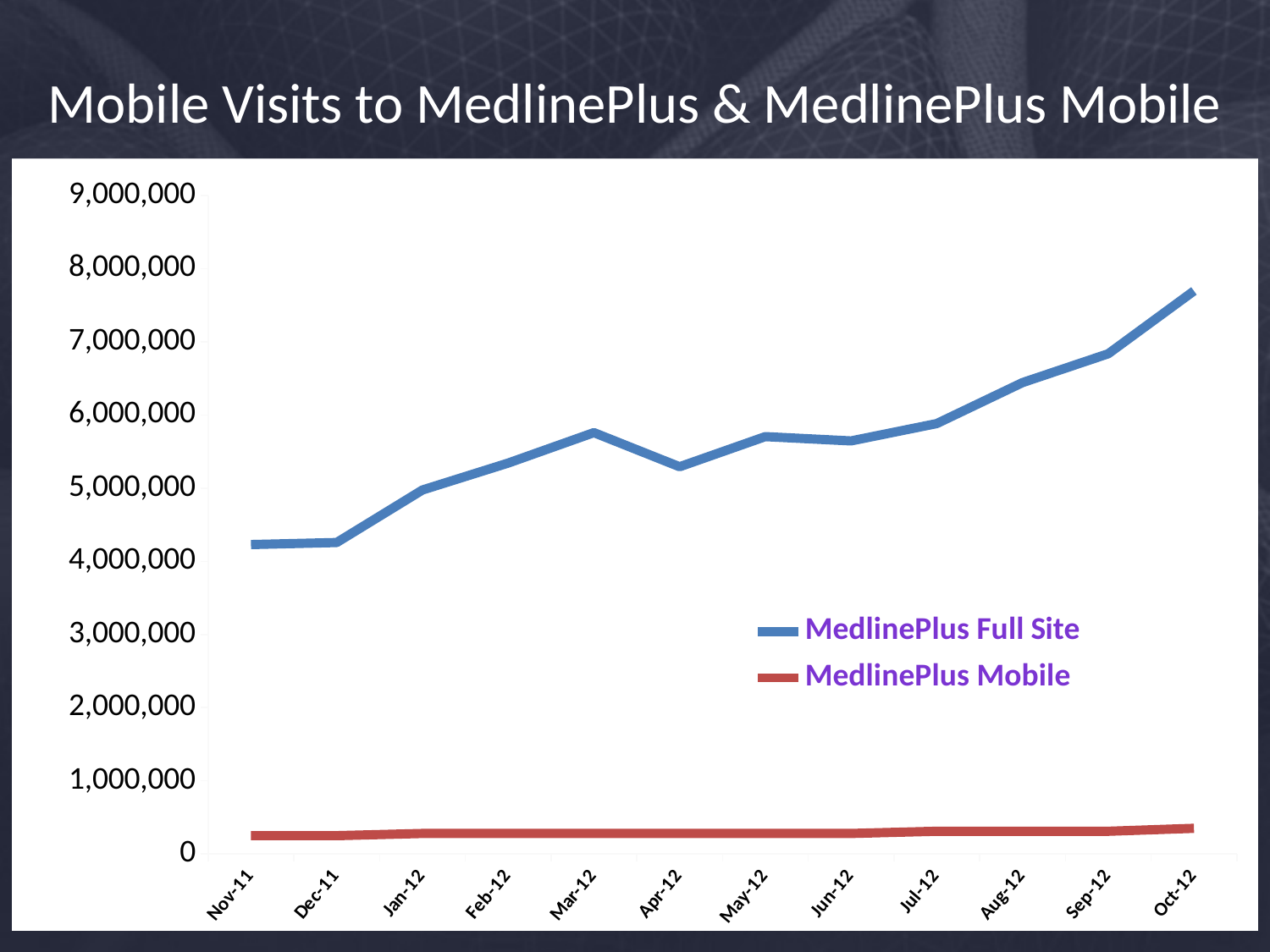
Overall, does the MedlinePlus Full Site series rise or fall from Nov-11 to Oct-12? rise Is the MedlinePlus Full Site value for Nov-11 greater or less than 5,000,000? less Is the MedlinePlus Mobile value for Oct-12 greater or less than 1,000,000? less How many series does the legend list? 2 In Jul-12, which series has the larger value, MedlinePlus Full Site or MedlinePlus Mobile? MedlinePlus Full Site How many months are plotted along the x axis? 12 What kind of chart is shown on the slide? line chart Is the MedlinePlus Full Site value for Mar-12 greater or less than 5,000,000? greater What is the title of the chart on the slide? Mobile Visits to MedlinePlus & MedlinePlus Mobile For the MedlinePlus Full Site series, which month has the larger value, Mar-12 or Apr-12? Mar-12 In which month does the MedlinePlus Full Site series reach its highest value? Oct-12